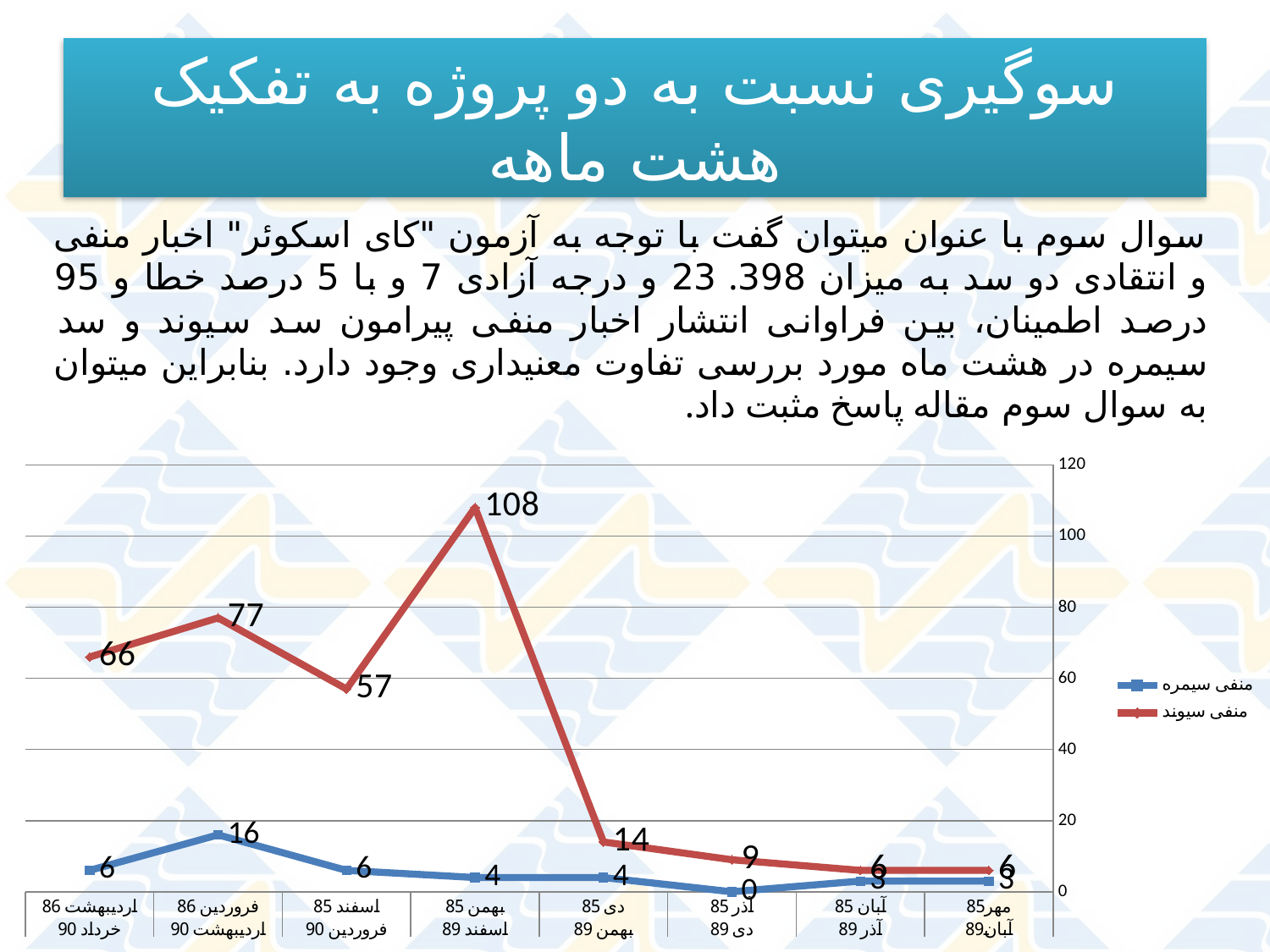
What is the value of منفی سیمره for فروردین 86 / اردیبهشت 90? 16 In which category does منفی سیمره reach its lowest value? آذر 85 / دی 89 What is the difference between منفی سیوند and منفی سیمره for فروردین 86 / اردیبهشت 90? 61 What is the value of منفی سیوند for اسفند 85 / فروردین 90? 57 In which category does منفی سیوند reach its highest value? بهمن 85 / اسفند 89 What type of chart is shown on the slide? Line chart Does منفی سیوند rise or fall from مهر 85 / آبان 89 to بهمن 85 / اسفند 89? Rise Which colour is used for the منفی سیوند series? Red Which series has the larger value for اردیبهشت 86 / خرداد 90, منفی سیوند or منفی سیمره? منفی سیوند How many series does the legend list? 2 How many categories are shown on the x axis? 8 What is the value of منفی سیوند for بهمن 85 / اسفند 89? 108